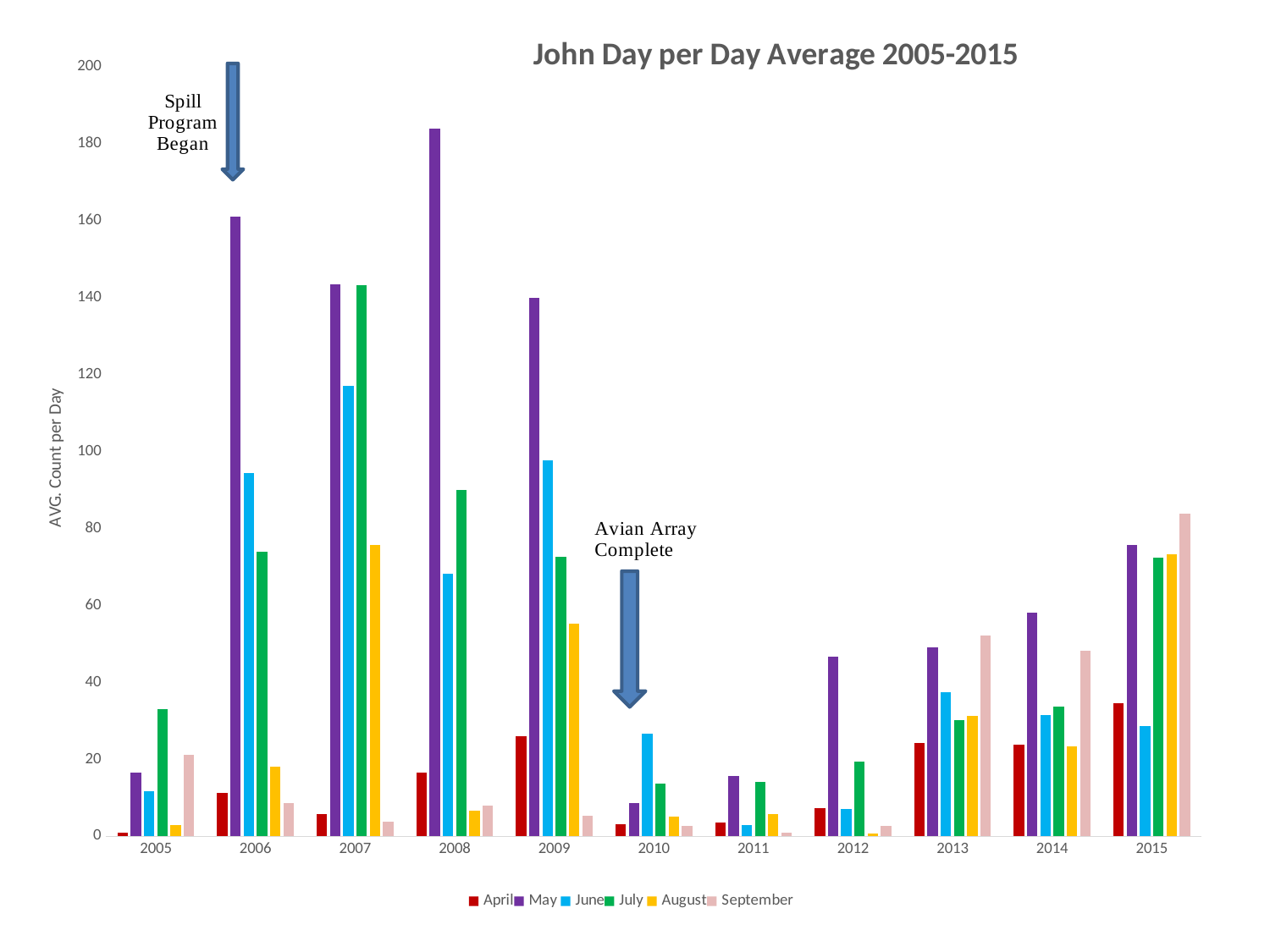
What is the title of the chart? John Day per Day Average 2005-2015 Is the value for June in 2006 greater or less than 80? greater Which month has the lowest bar in 2005? April Which is larger in 2014, the May value or the June value? May How many series does the legend list? 6 Is the value for September in 2015 greater or less than 60? greater In which year is the May bar the highest? 2008 Is the value for May in 2008 greater or less than 180? greater What kind of chart is shown on the slide? bar chart Which is larger, the May value in 2006 or the May value in 2009? 2006 How many years are shown along the x axis? 11 Which month has the highest bar in 2015? September